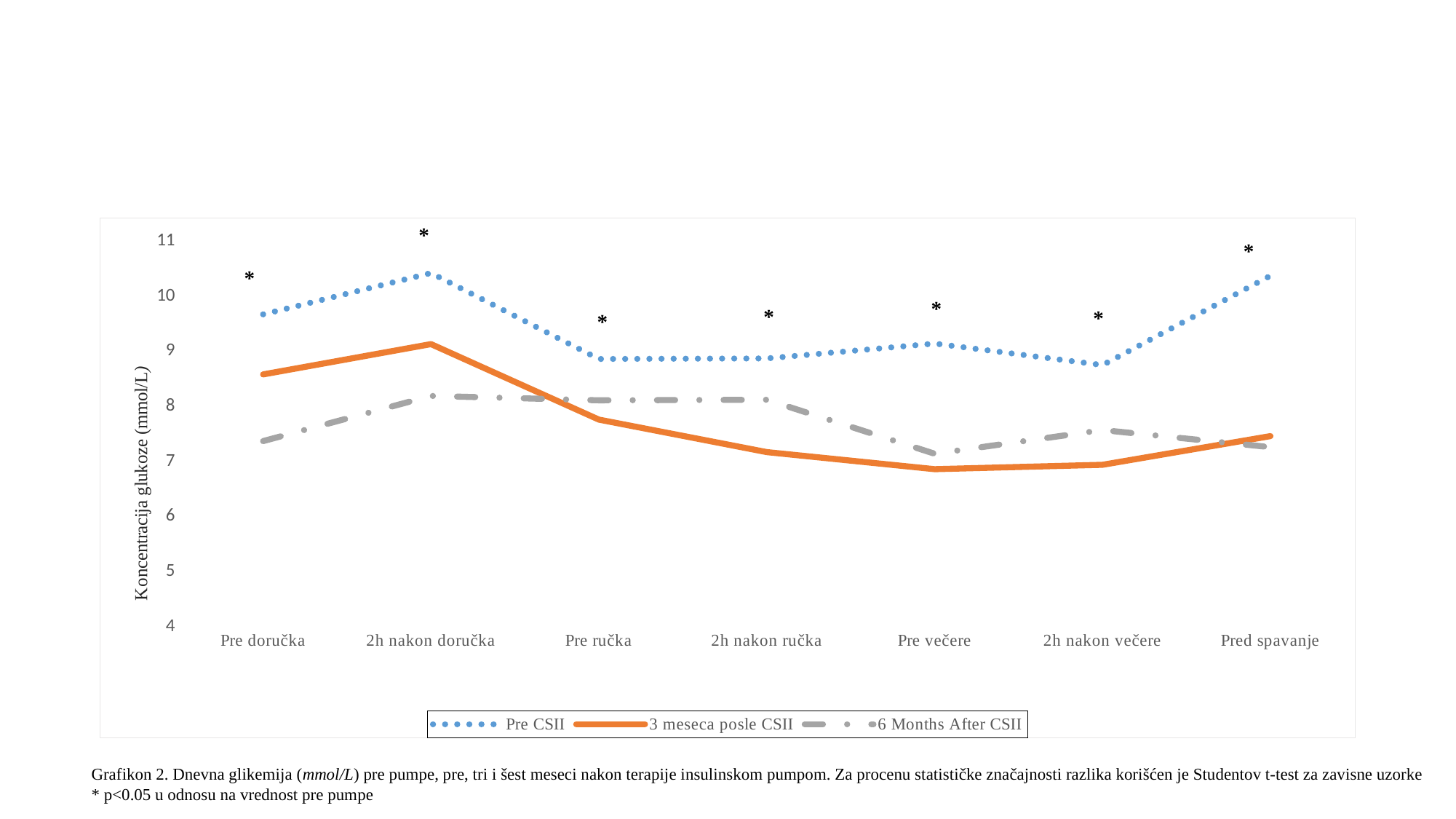
At 'Pre doručka', which series has the larger value: 'Pre CSII' or '3 meseca posle CSII'? Pre CSII Which category has the highest value for the '3 meseca posle CSII' series? 2h nakon doručka At 'Pre doručka', which series has the larger value: '3 meseca posle CSII' or '6 Months After CSII'? 3 meseca posle CSII Is the '3 meseca posle CSII' value at 'Pre večere' greater or less than 7? less Is the '6 Months After CSII' value at 'Pre doručka' greater or less than 8? less Is the 'Pre CSII' value at '2h nakon doručka' greater or less than 10? greater How many series does the legend list? 3 How many time-of-day categories are shown on the x axis? 7 What kind of chart is shown on the slide? Line chart Does the '3 meseca posle CSII' series rise or fall from '2h nakon doručka' to 'Pre večere'? Fall What is the label of the y axis? Koncentracija glukoze (mmol/L)